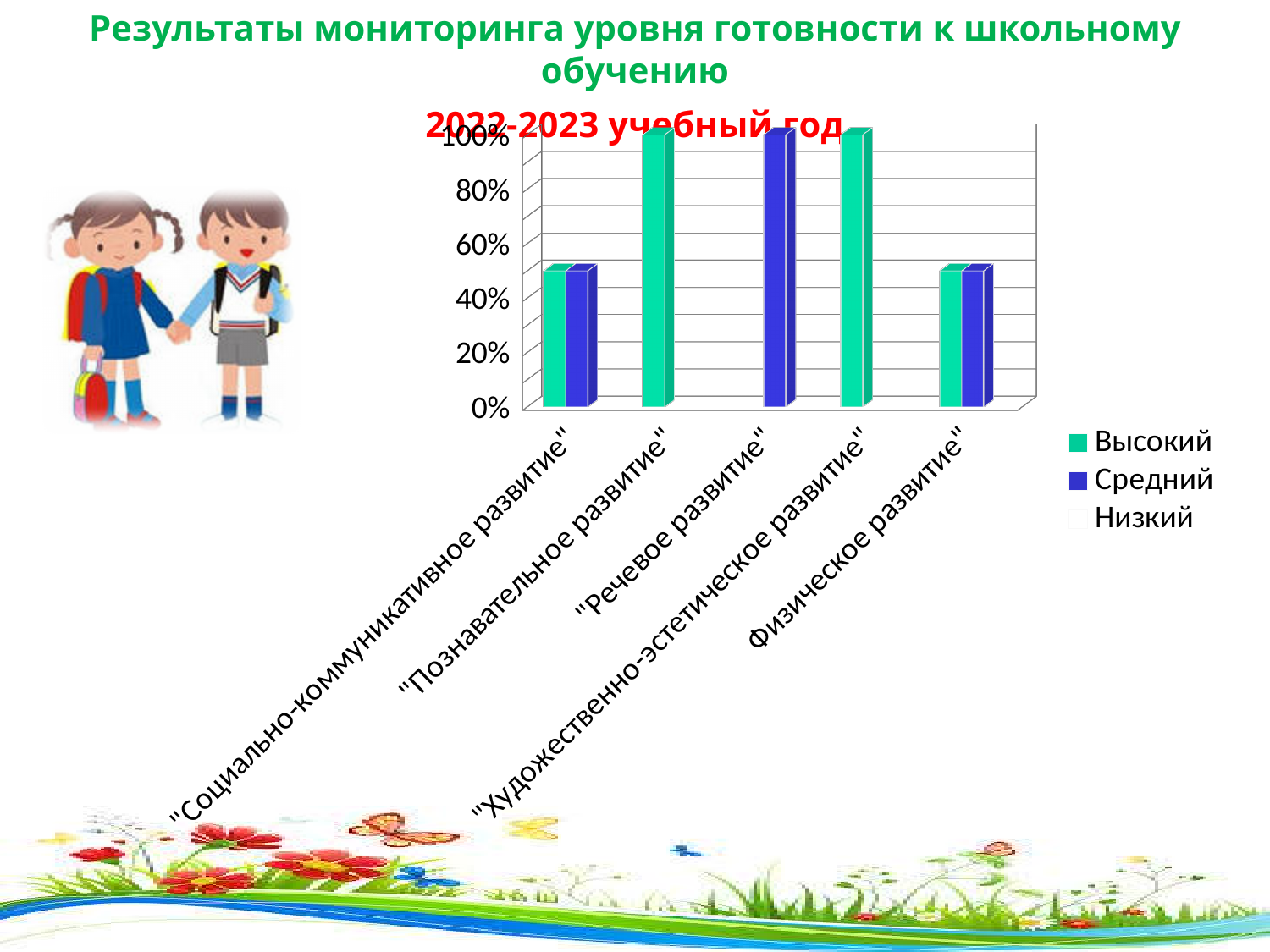
Which legend entry is listed last? Низкий What kind of chart is shown on the slide? bar chart What is the value of the Высокий series for "Познавательное развитие"? 100% Which series is shown in green in the legend? Высокий Is the value of the Средний series for "Физическое развитие" greater or less than 60%? less Which is larger: the Высокий value for "Познавательное развитие" or the Высокий value for "Физическое развитие"? "Познавательное развитие" What is the value of the Высокий series for "Художественно-эстетическое развитие"? 100% Is the value of the Высокий series for "Социально-коммуникативное развитие" greater or less than 40%? greater How many series does the legend list? 3 How many categories are shown on the x axis of the chart? 5 What is the value of the Средний series for "Речевое развитие"? 100% Which is larger for "Речевое развитие": the Высокий series or the Средний series? Средний